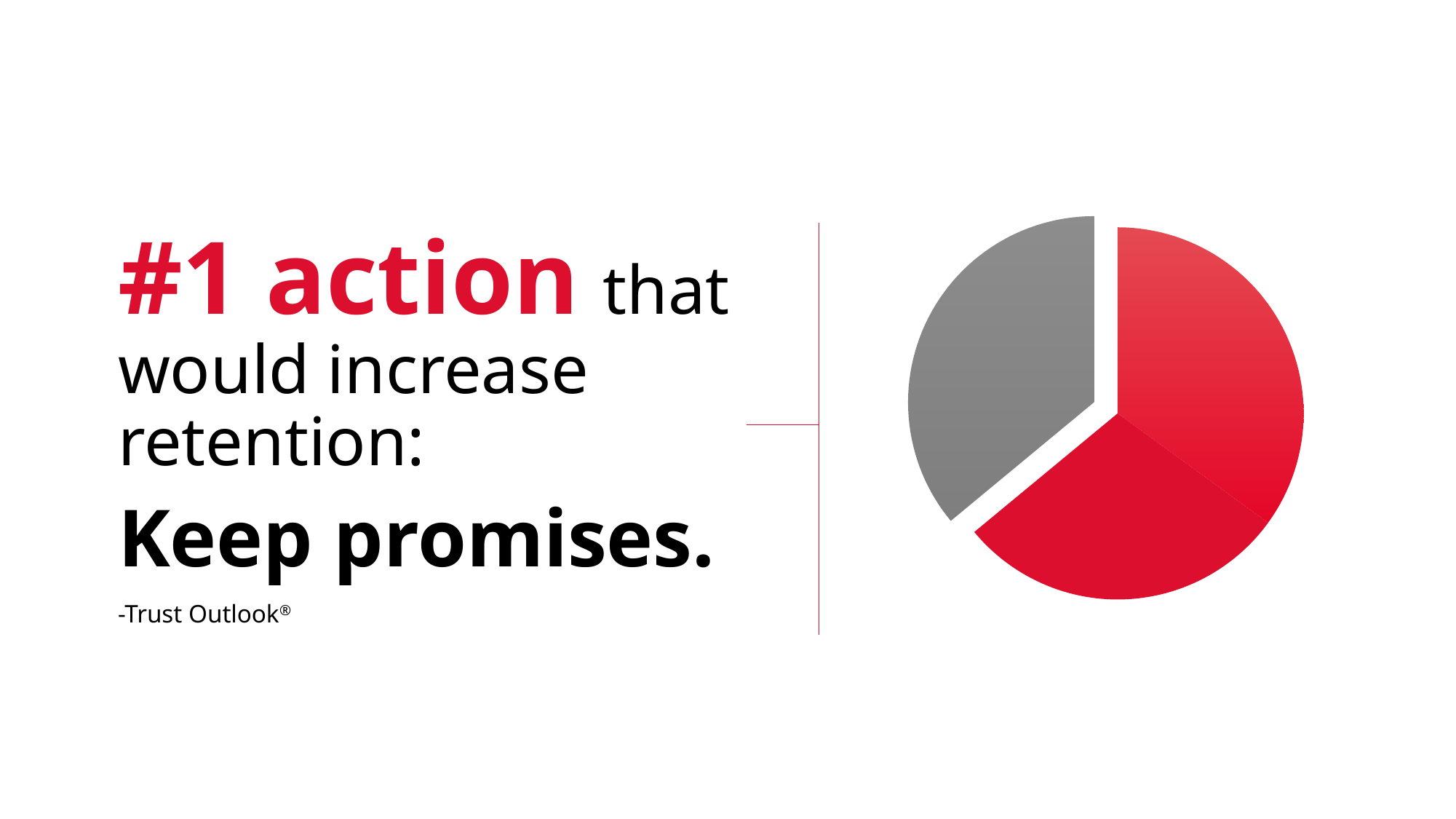
Is the red slice of the pie chart more or less than half of the pie? more How many slices does the pie chart have? 3 Does the pie chart display a legend? No What kind of chart is shown on the right side of the slide? pie chart What two colours are used for the slices of the pie chart? red and grey Which slice of the pie chart is larger, the red one or the grey one? red